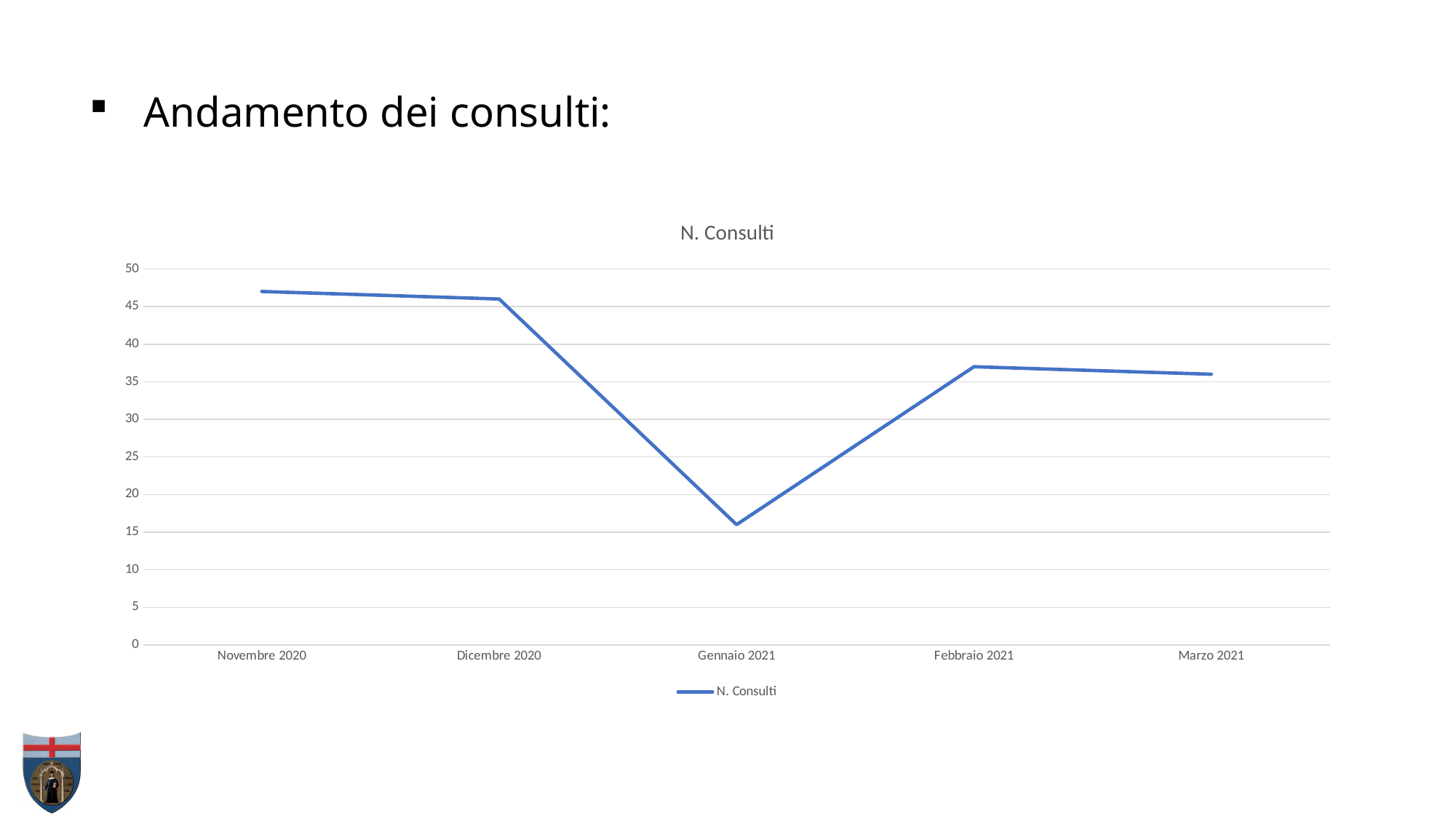
Is the value for Marzo 2021 greater or less than 40? less What is the title of the chart? N. Consulti How many series does the chart legend list? 1 Which month has the lowest value for N. Consulti? Gennaio 2021 Is the value for Novembre 2020 greater or less than 45? greater Which is larger, the value for Dicembre 2020 or the value for Gennaio 2021? Dicembre 2020 What kind of chart is shown on the slide? line chart How many months are plotted on the x axis of the chart? 5 Does the value rise or fall from Gennaio 2021 to Febbraio 2021? rise Is the value for Gennaio 2021 greater or less than 20? less Does the value rise or fall from Dicembre 2020 to Gennaio 2021? fall